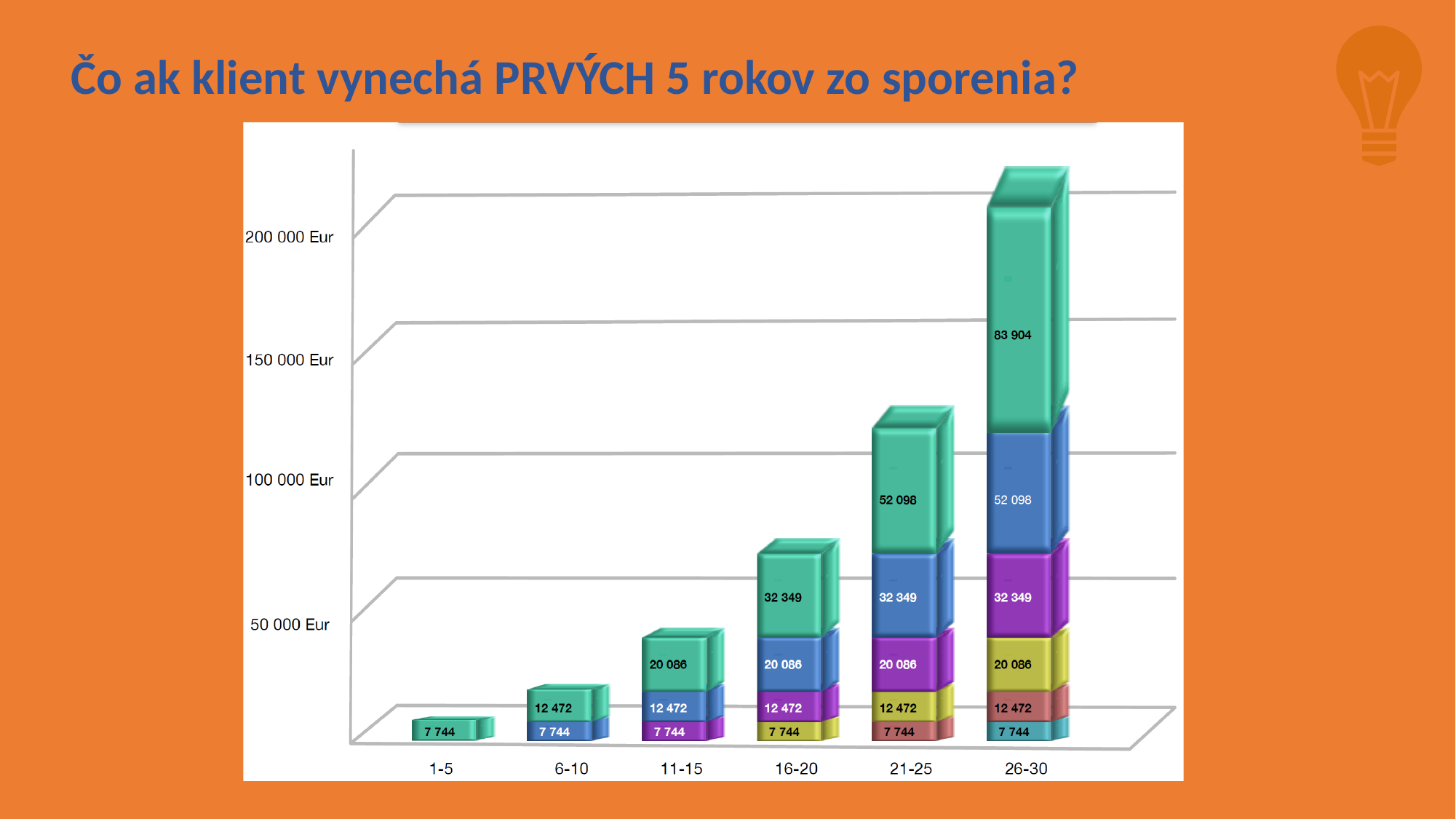
What is the value of the top segment of the 21-25 bar? 52 098 What is the value of the top segment of the 26-30 bar? 83 904 What kind of chart is shown on the slide? stacked bar chart What is the total of the stacked bar for 11-15? 40 302 What is the value of the single segment in the 1-5 bar? 7 744 Is the total for 21-25 greater or less than 100 000 Eur? greater Which category has the highest total bar? 26-30 What is the total of the stacked bar for 26-30? 208 653 How many categories are shown on the x axis? 6 Do the bar totals rise or fall from 1-5 to 26-30? rise What is the total of the stacked bar for 6-10? 20 216 Which category has the lowest total bar? 1-5